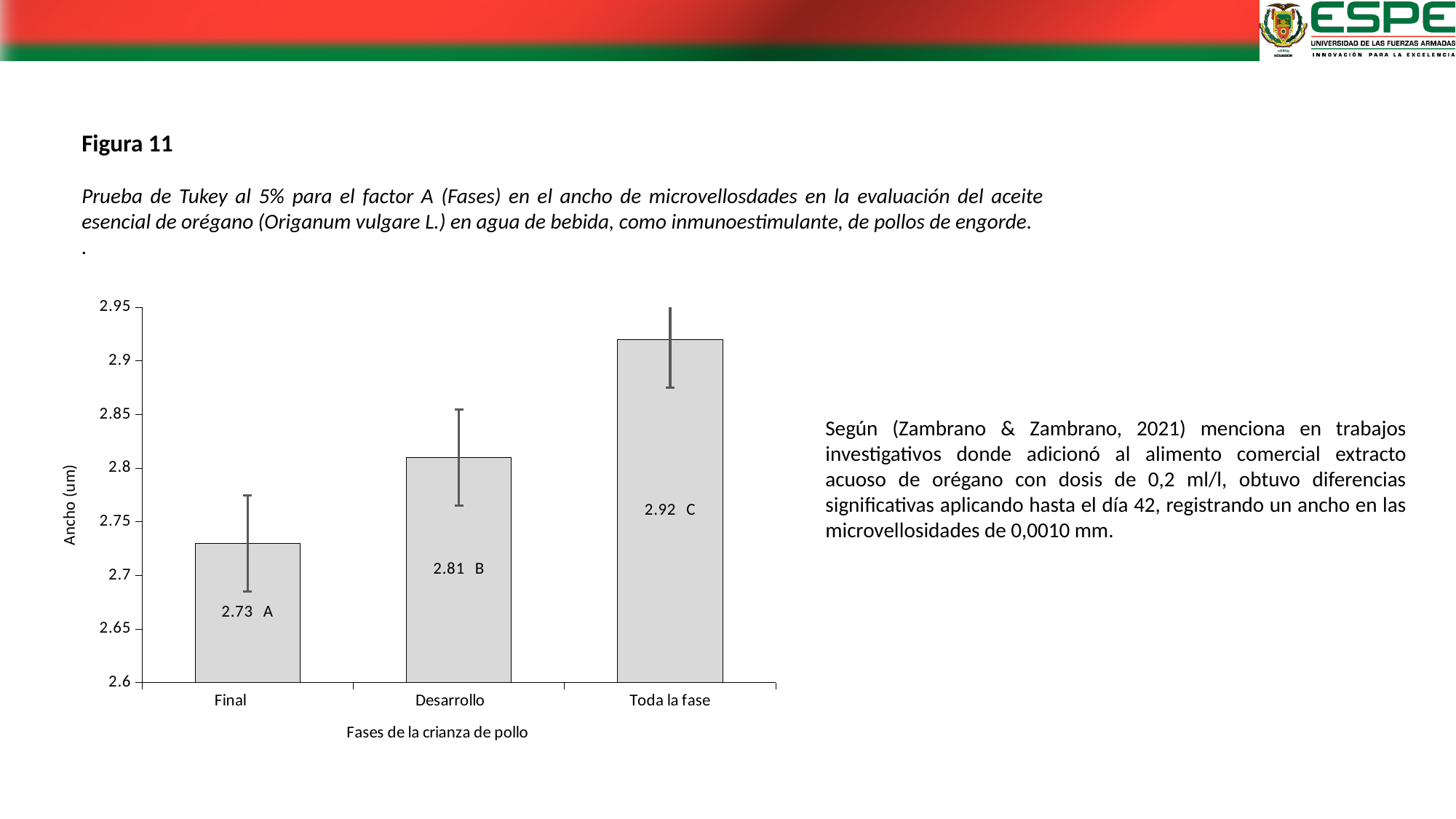
What is the value for Toda la fase? 2.92 What is the value for Desarrollo? 2.81 How many phases are shown on the x axis? 3 Is the value for Toda la fase greater or less than 2.9? greater Which phase has the lowest width? Final What is the value for Final? 2.73 Which phase has the highest width? Toda la fase What is the difference between the values for Toda la fase and Final? 0.19 What is the difference between the values for Desarrollo and Final? 0.08 What kind of chart is this? bar chart Which is larger, the value for Desarrollo or the value for Final? Desarrollo Do the values rise or fall from Final to Toda la fase? rise